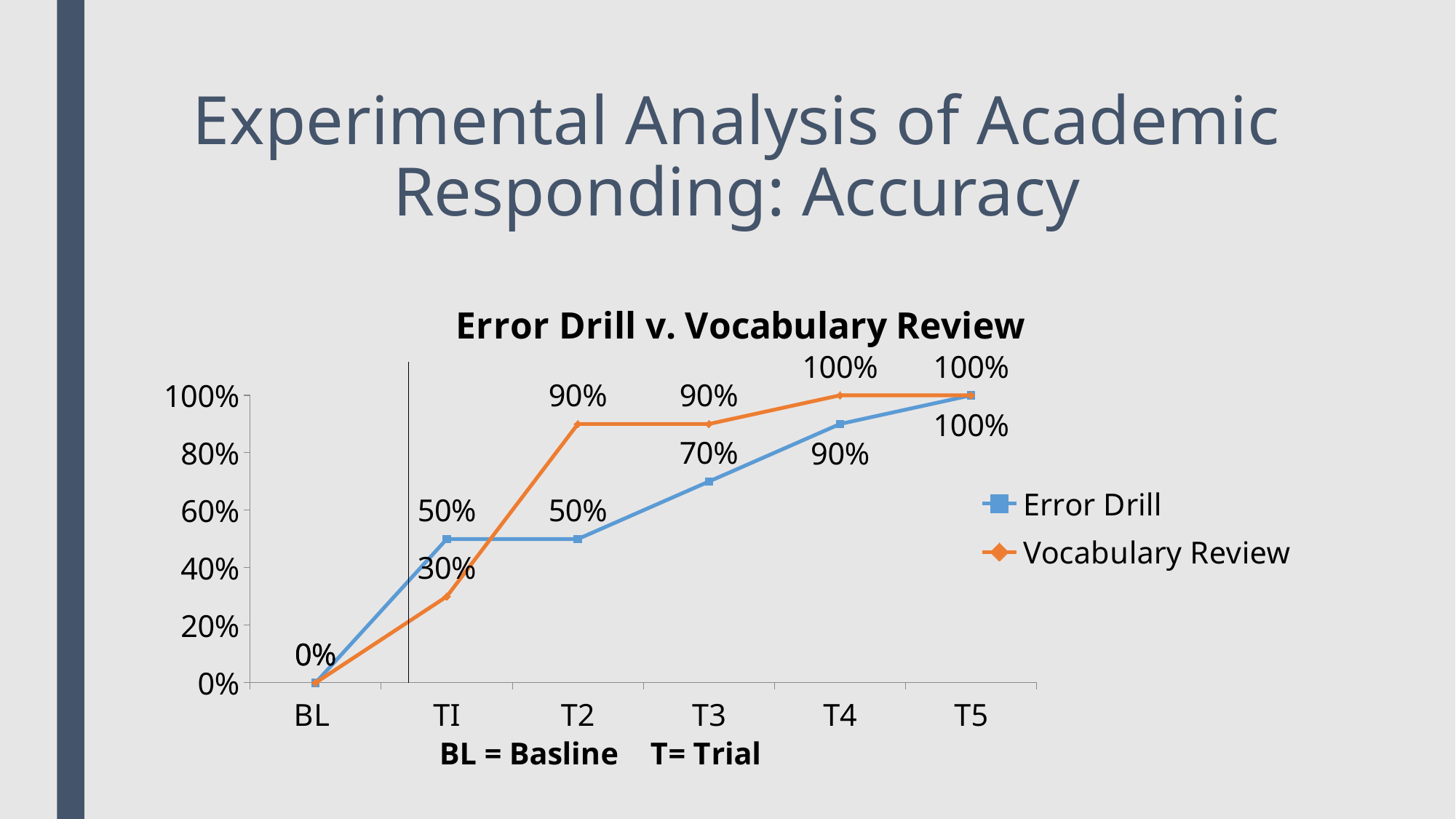
What kind of chart is shown on the slide? Line chart Does the Error Drill series rise or fall from BL to T5? Rise What is the title of the chart? Error Drill v. Vocabulary Review At which category is the Error Drill value lowest? BL What is the Error Drill value at T3? 70% What is the Vocabulary Review value at T2? 90% What is the difference between the Vocabulary Review and Error Drill values at T2? 40% At TI, which series has the higher value, Error Drill or Vocabulary Review? Error Drill How many points are plotted along the x axis for each series? 6 What is the Vocabulary Review value at TI? 30% How many series does the legend list? 2 What is the Error Drill value at T4? 90%